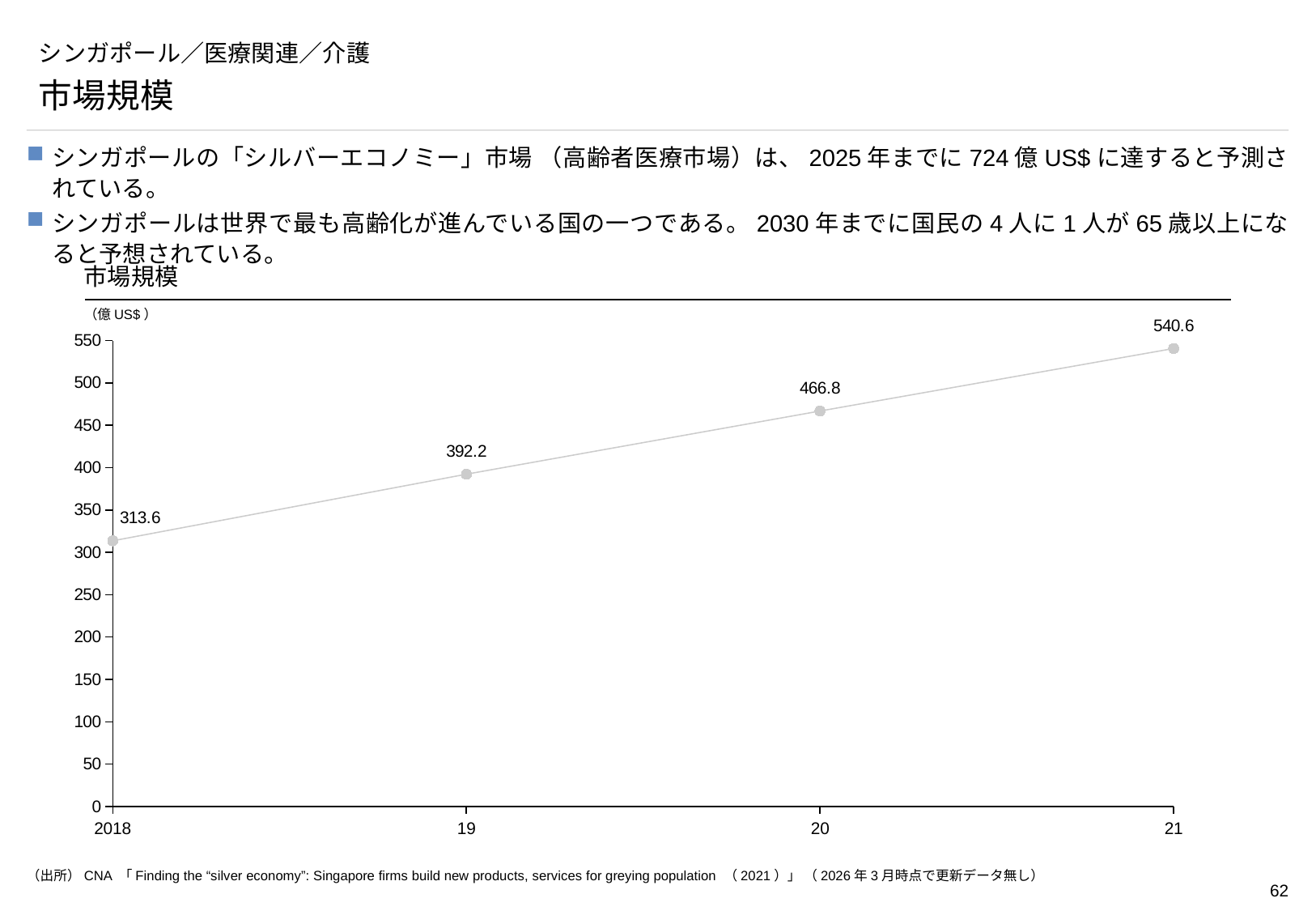
What is the market size value for 2018? 313.6 Which year has the lowest market size? 2018 Do the values rise or fall from 2018 to 2021? Rise What is the difference between the 2021 and 2018 market size values? 227.0 Which is larger, the value for 2019 or the value for 2020? 2020 What is the difference between the 2020 and 2019 market size values? 74.6 What is the market size value for 2021 (labelled 21)? 540.6 What is the market size value for 2020 (labelled 20)? 466.8 How many data points are plotted on the chart? 4 What is the market size value for 2019 (labelled 19)? 392.2 Which year has the highest market size? 21 What kind of chart is shown on the slide? Line chart